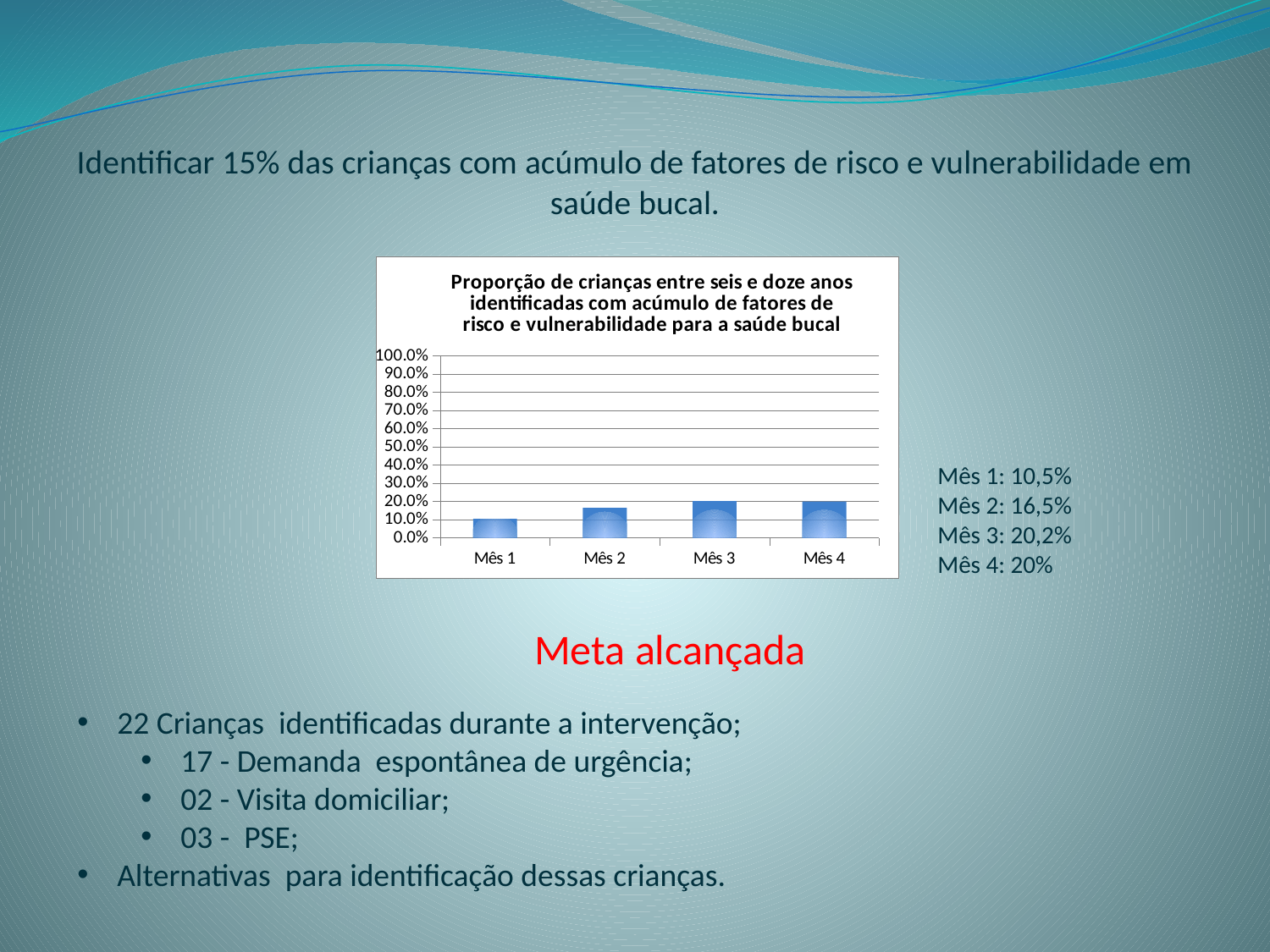
According to the slide, what is the value for Mês 1? 10,5% What is the highest tick value shown on the chart's vertical axis? 100.0% What is the difference between the values for Mês 2 and Mês 1 as given on the slide? 6% According to the slide, what is the value for Mês 2? 16,5% Is the value for Mês 1 greater or less than 20.0%? less How many months (categories) are plotted on the x axis of the chart? 4 Do the bar values rise or fall from Mês 1 to Mês 3? rise Which month has the lowest bar in the chart? Mês 1 What kind of chart is shown on the slide? bar chart According to the slide, what is the value for Mês 3? 20,2% Which is larger, the value for Mês 2 or the value for Mês 1? Mês 2 According to the slide, what is the value for Mês 4? 20%